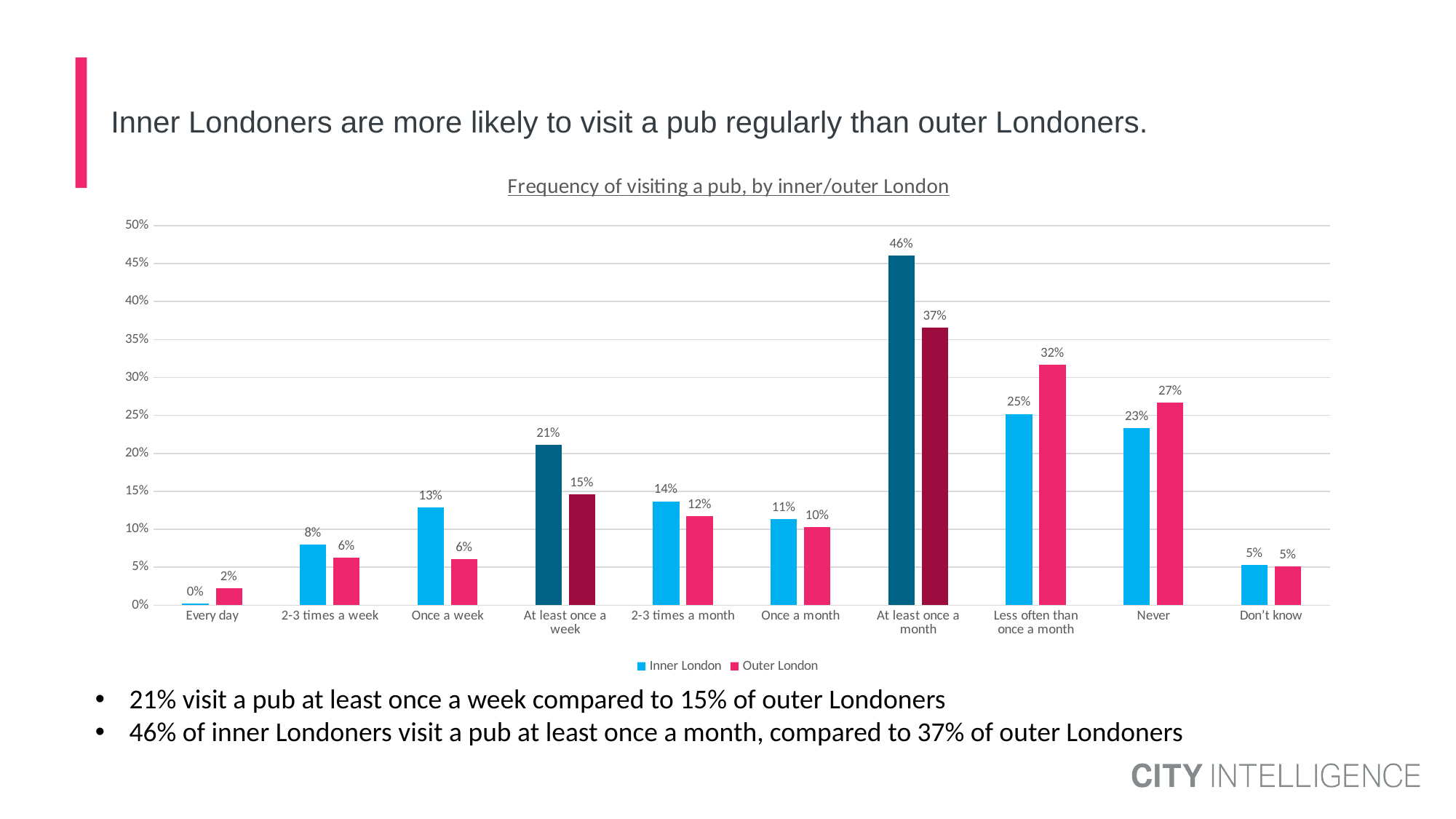
What is the Inner London value for 'Once a week'? 13% What is the difference between the Inner London and Outer London values for 'At least once a week'? 6% What is the Inner London value for 'At least once a month'? 46% Which category has the highest Outer London value? At least once a month Which is larger for 'Never': Inner London or Outer London? Outer London What is the Outer London value for 'Less often than once a month'? 32% How many categories are shown on the x axis? 10 What is the difference between the Inner London and Outer London values for 'At least once a month'? 9% What type of chart is shown on the slide? Bar chart How many series does the legend list? 2 Which category has the lowest Inner London value? Every day Is the Inner London value for 'At least once a month' greater or less than 40%? greater